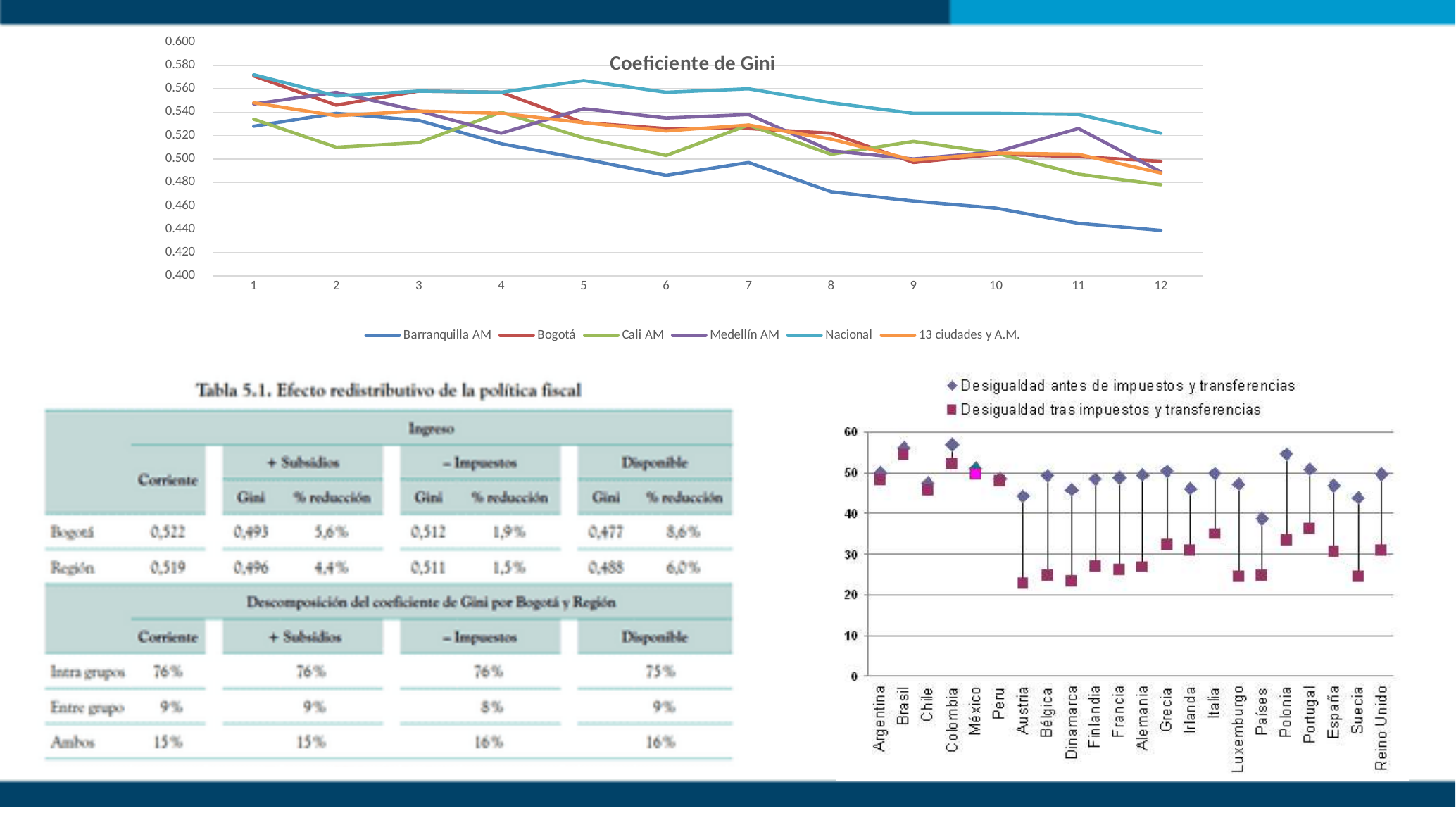
In the 'Coeficiente de Gini' chart, which is larger at point 1: Nacional or Cali AM? Nacional In the 'Coeficiente de Gini' chart, does the Barranquilla AM line rise or fall from point 1 to point 12? Falls In the 'Coeficiente de Gini' chart, which series has the lowest value at point 12? Barranquilla AM In the bottom-right chart, is the 'Desigualdad tras impuestos y transferencias' value for Austria greater or less than 30? less In the 'Coeficiente de Gini' chart, is the value for Nacional at point 5 greater or less than 0.560? greater In the 'Coeficiente de Gini' chart, which series has the highest value at point 12? Nacional In the 'Coeficiente de Gini' chart, is the value for Barranquilla AM at point 12 greater or less than 0.460? less How many countries are shown on the x axis of the bottom-right chart? 22 How many series does the legend of the 'Coeficiente de Gini' chart list? 6 How many series does the legend of the bottom-right chart list? 2 What kind of chart is the 'Coeficiente de Gini' chart at the top of the slide? Line chart How many points are there along the x axis of the 'Coeficiente de Gini' chart? 12